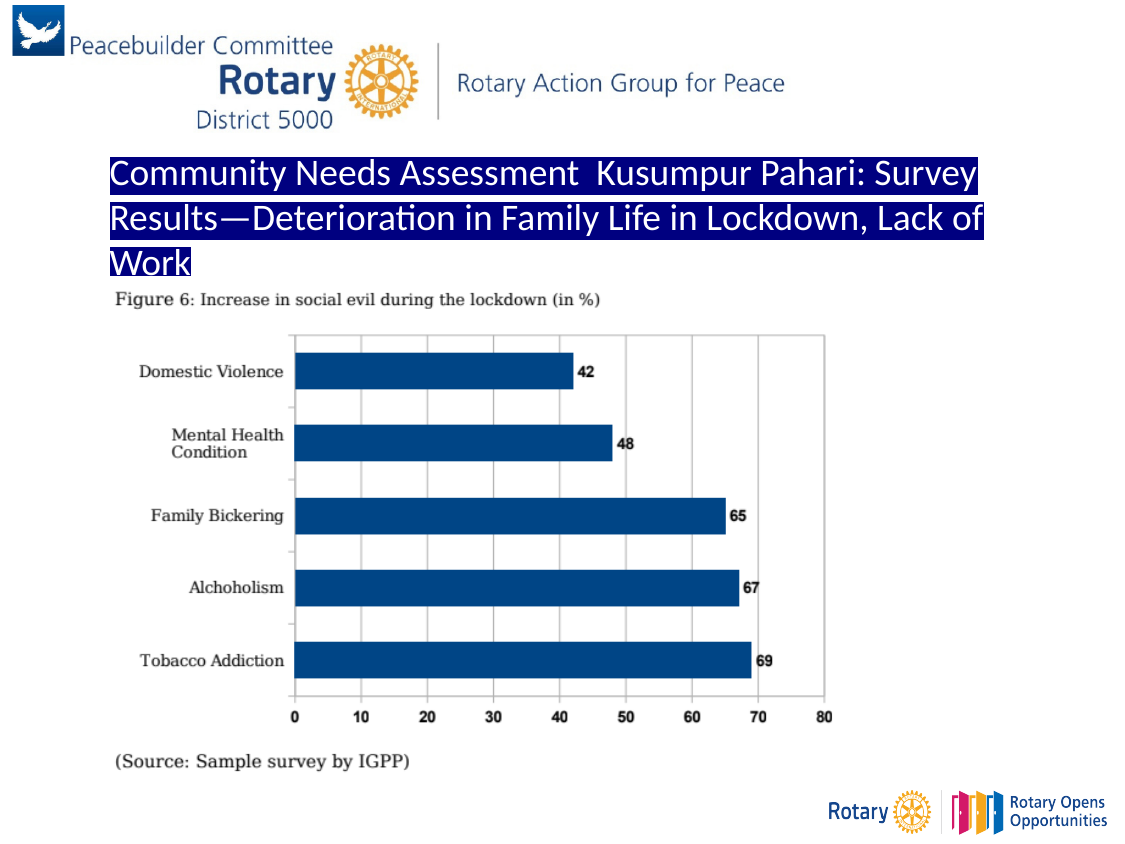
Which category has the highest value? Tobacco Addiction What is the value for Tobacco Addiction? 69 Which is larger, the value for Mental Health Condition or the value for Family Bickering? Family Bickering How many categories are shown in the chart? 5 What is the title of the chart? Figure 6: Increase in social evil during the lockdown (in %) What is the value for Family Bickering? 65 What is the difference between the values for Alchoholism and Family Bickering? 2 Which category has the lowest value? Domestic Violence What is the difference between the values for Tobacco Addiction and Domestic Violence? 27 What kind of chart is shown on the slide? Bar chart What is the value for Mental Health Condition? 48 What is the value for Domestic Violence? 42